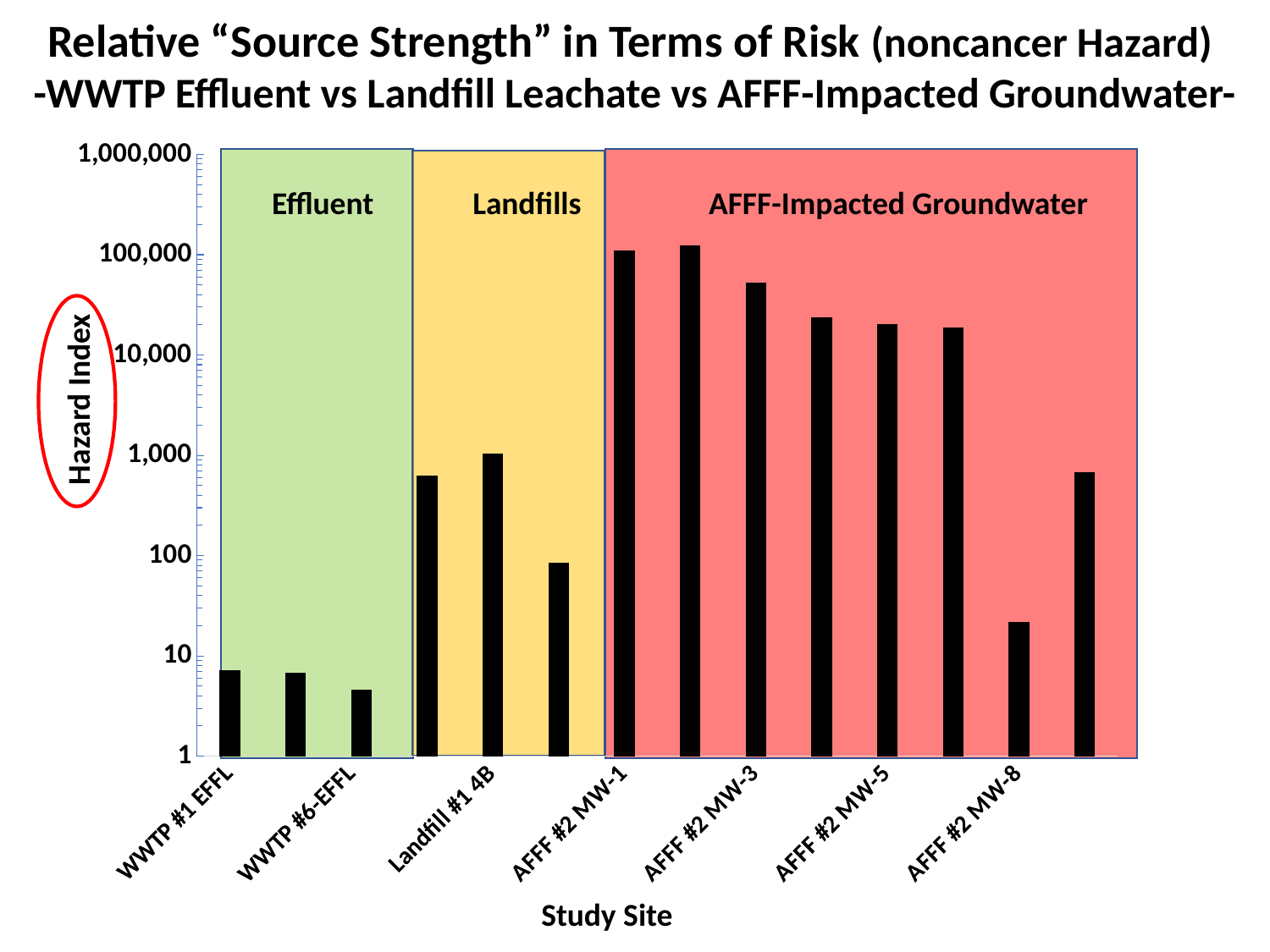
Is the Hazard Index for AFFF #2 MW-1 greater or less than 10,000? greater Which has the larger Hazard Index, Landfill #1 4B or AFFF #2 MW-8? Landfill #1 4B Which has the larger Hazard Index, AFFF #2 MW-1 or WWTP #1 EFFL? AFFF #2 MW-1 What is the title of the vertical axis of the chart? Hazard Index Is the Hazard Index for WWTP #6-EFFL greater or less than 10? less What kind of chart is shown on the slide? bar chart How many bars are plotted in the chart? 14 Is the Hazard Index for WWTP #1 EFFL greater or less than 10? less What are the three shaded groups labelled in the chart? Effluent, Landfills, AFFF-Impacted Groundwater